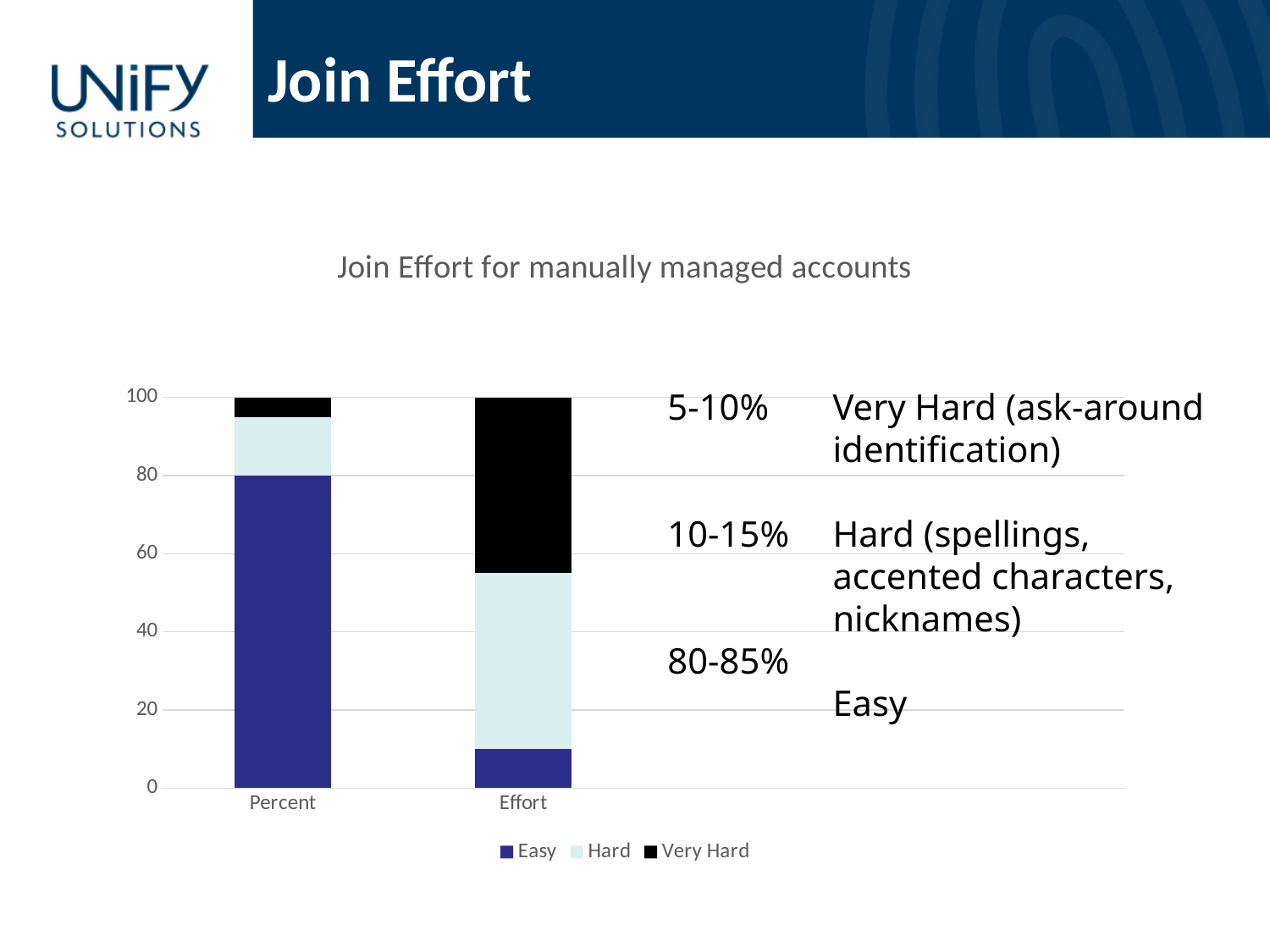
Which series is drawn in black in the chart? Very Hard What is the total height of the Effort stacked bar? 100 Is the Very Hard segment in the Percent bar greater or less than 20? less What kind of chart is shown on the slide? stacked bar chart What is the value of the Easy segment in the Percent bar? 80 Which bar has the larger Easy segment, Percent or Effort? Percent Is the Very Hard segment in the Effort bar greater or less than 40? greater How many series does the chart legend list? 3 Which bar has the larger Very Hard segment, Percent or Effort? Effort Is the Easy segment in the Effort bar greater or less than 20? less What is the title of the chart? Join Effort for manually managed accounts How many categories are shown on the x axis of the chart? 2